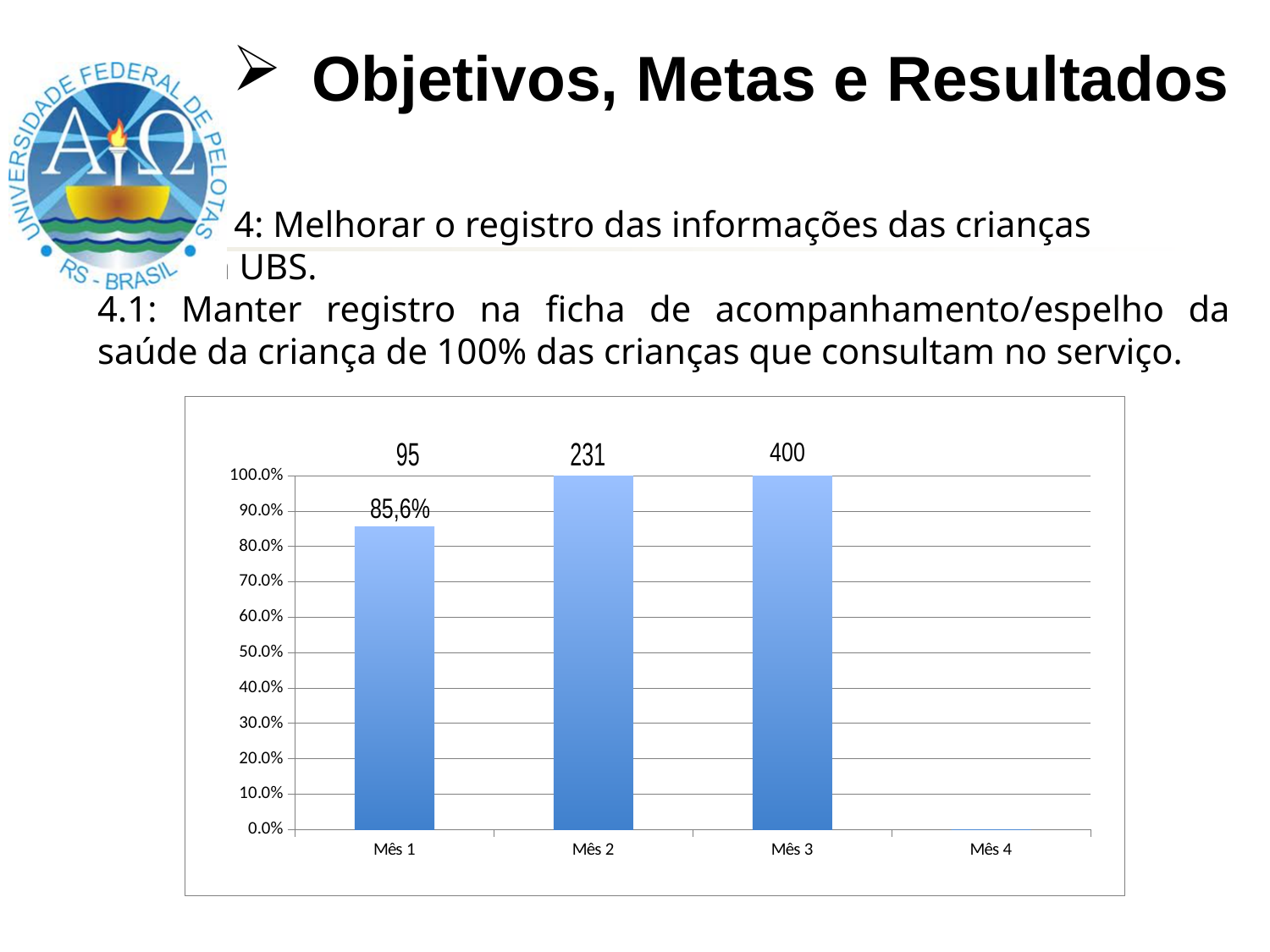
What is the difference between the value for Mês 2 and the value for Mês 1? 14.4 percentage points What number is printed above the bar for Mês 3? 400 Do the values rise or fall from Mês 1 to Mês 2? rise Is the value for Mês 1 greater or less than 80%? greater Is the value for Mês 4 greater or less than 10%? less What is the value for Mês 2 in the chart? 100.0% How many categories (months) are shown on the x axis of the chart? 4 What is the value for Mês 3 in the chart? 100.0% What kind of chart is shown on the slide? bar chart Which is larger, the value for Mês 1 or the value for Mês 2? Mês 2 Which month has the lowest value in the chart? Mês 4 What is the value for Mês 1 in the chart? 85,6%